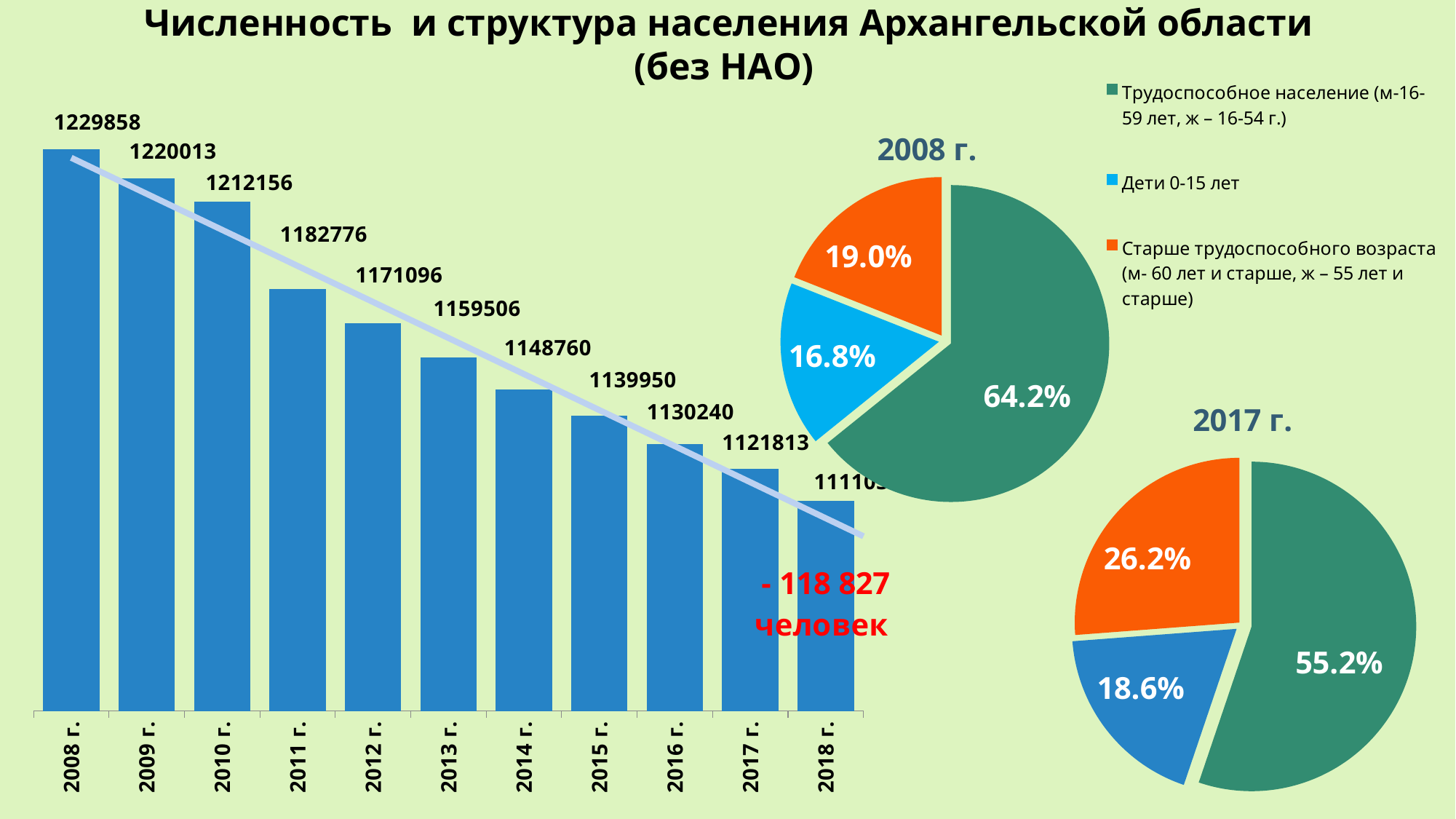
In the 2008 pie chart, what share is labelled for the working-age population (Трудоспособное население)? 64.2% In the bar chart on the left, which is larger, the value for 2011 or the value for 2014? 2011 How many categories does the legend for the pie charts list? 3 In the bar chart on the left, how many years are shown on the x axis? 11 In the bar chart on the left, do the values rise or fall from 2008 to 2018? fall What kind of chart is the chart on the left of the slide? bar chart In the bar chart on the left, what is the population value for 2013? 1159506 In the bar chart on the left, what is the population value for 2017? 1121813 In the bar chart on the left, which year has the highest population? 2008 г. In the 2017 pie chart, what share is labelled for children 0-15 years (Дети 0-15 лет)? 18.6% In the bar chart on the left, what is the population value for 2008? 1229858 In the bar chart on the left, what is the difference between the 2008 and 2017 values? 108045